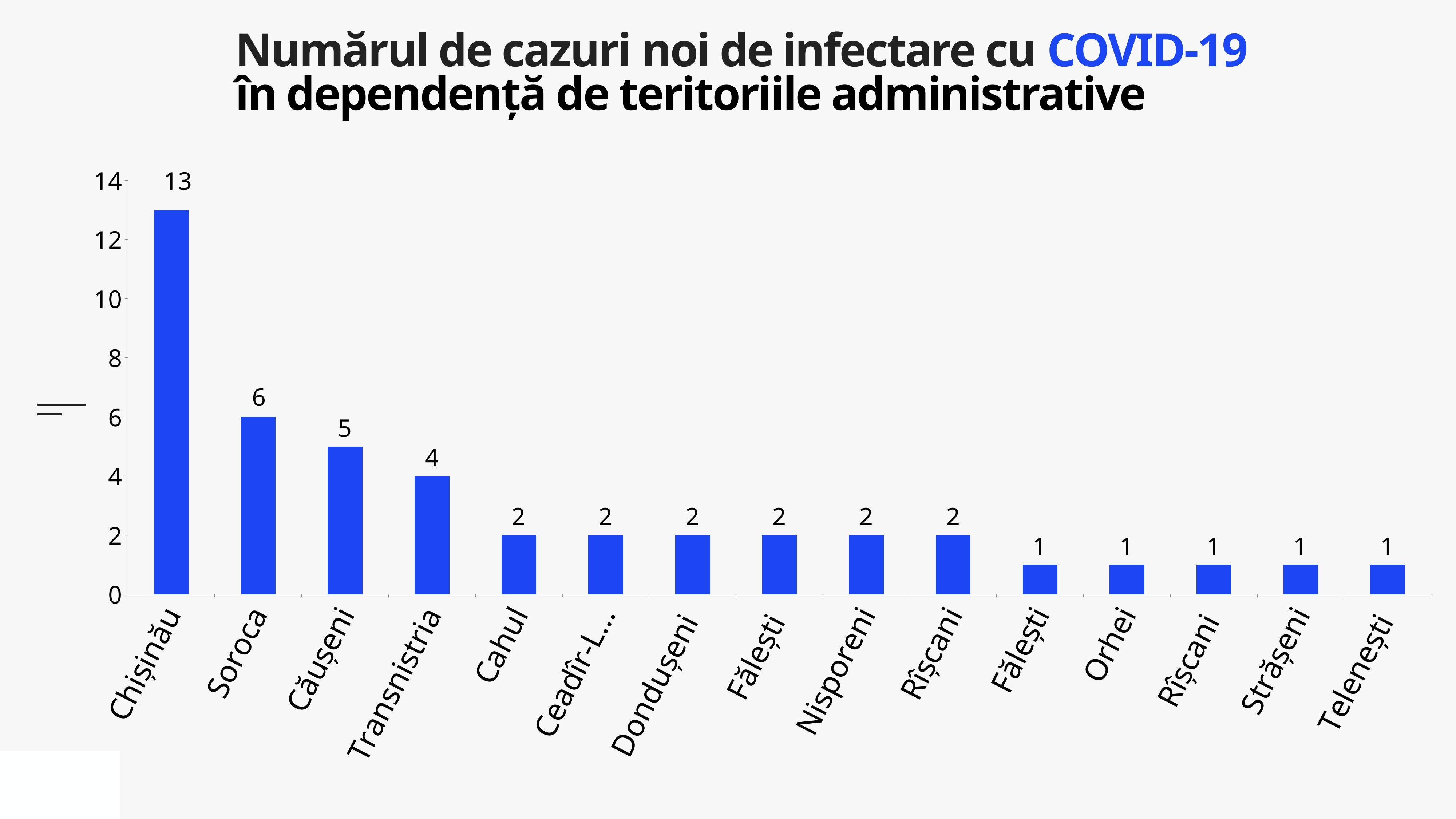
What is the value for Soroca? 6 What is the value for Cahul? 2 Which territory has the highest number of new cases? Chișinău What is the value for Orhei? 1 What is the value for Chișinău? 13 How many bars are shown in the chart? 15 What is the value for Transnistria? 4 What kind of chart is shown on the slide? bar chart What is the difference between the values for Chișinău and Soroca? 7 Which has a larger value, Căușeni or Transnistria? Căușeni Is the value for Chișinău greater or less than 10? greater What is the value for Căușeni? 5